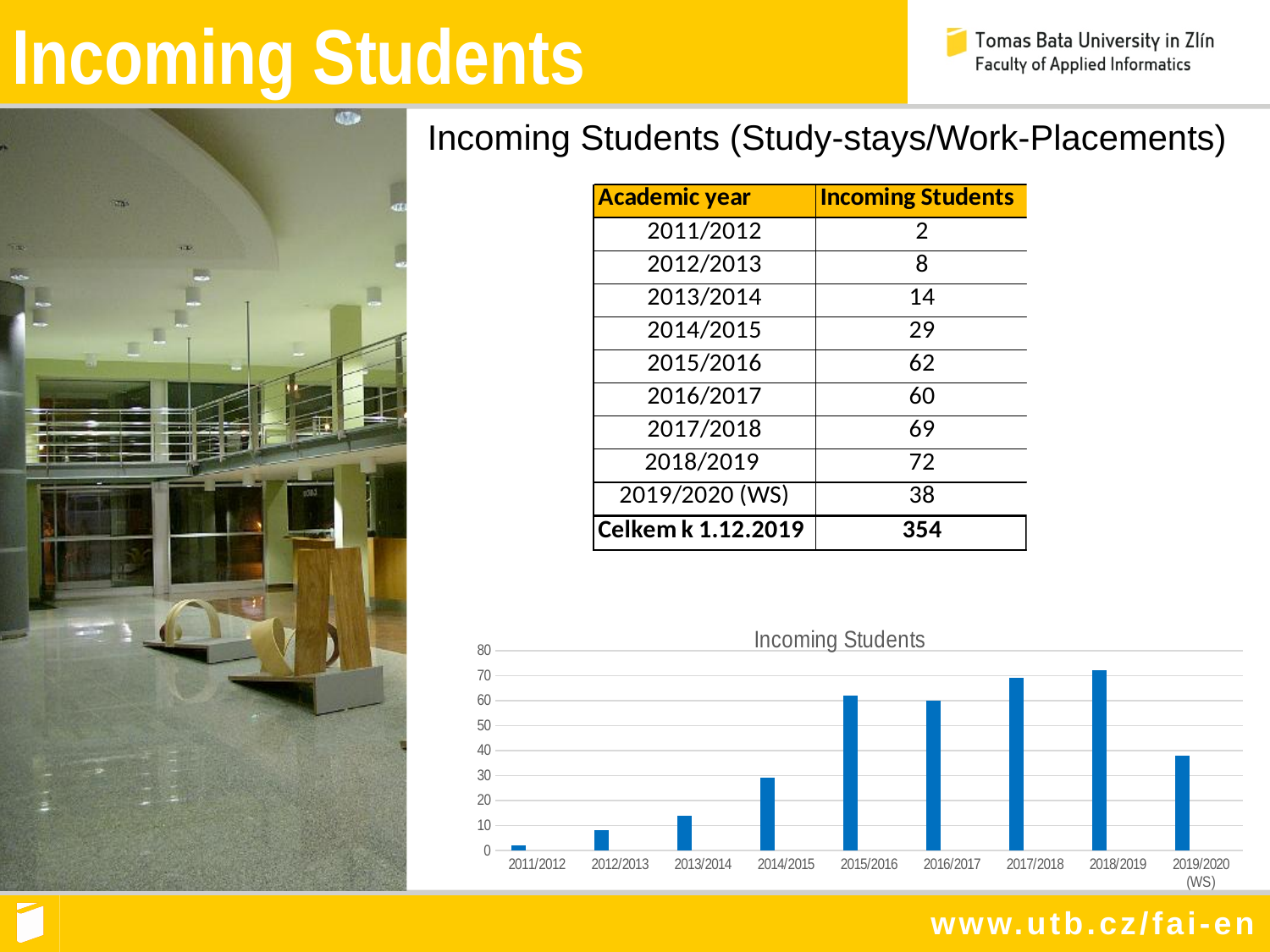
How many academic years are plotted on the x axis of the chart? 9 Which academic year has the highest bar in the chart? 2018/2019 What is the difference between the incoming students in 2018/2019 and 2017/2018? 3 What is the title of the chart? Incoming Students What kind of chart is shown on the slide? bar chart Is the value for 2015/2016 greater or less than 50? greater Which is larger, the value for 2017/2018 or the value for 2019/2020 (WS)? 2017/2018 Is the value for 2014/2015 greater or less than 40? less Is the value for 2019/2020 (WS) greater or less than 30? greater Do the values generally rise or fall from 2011/2012 to 2018/2019? rise Which academic year has the lowest bar in the chart? 2011/2012 How many incoming students are shown for 2016/2017? 60